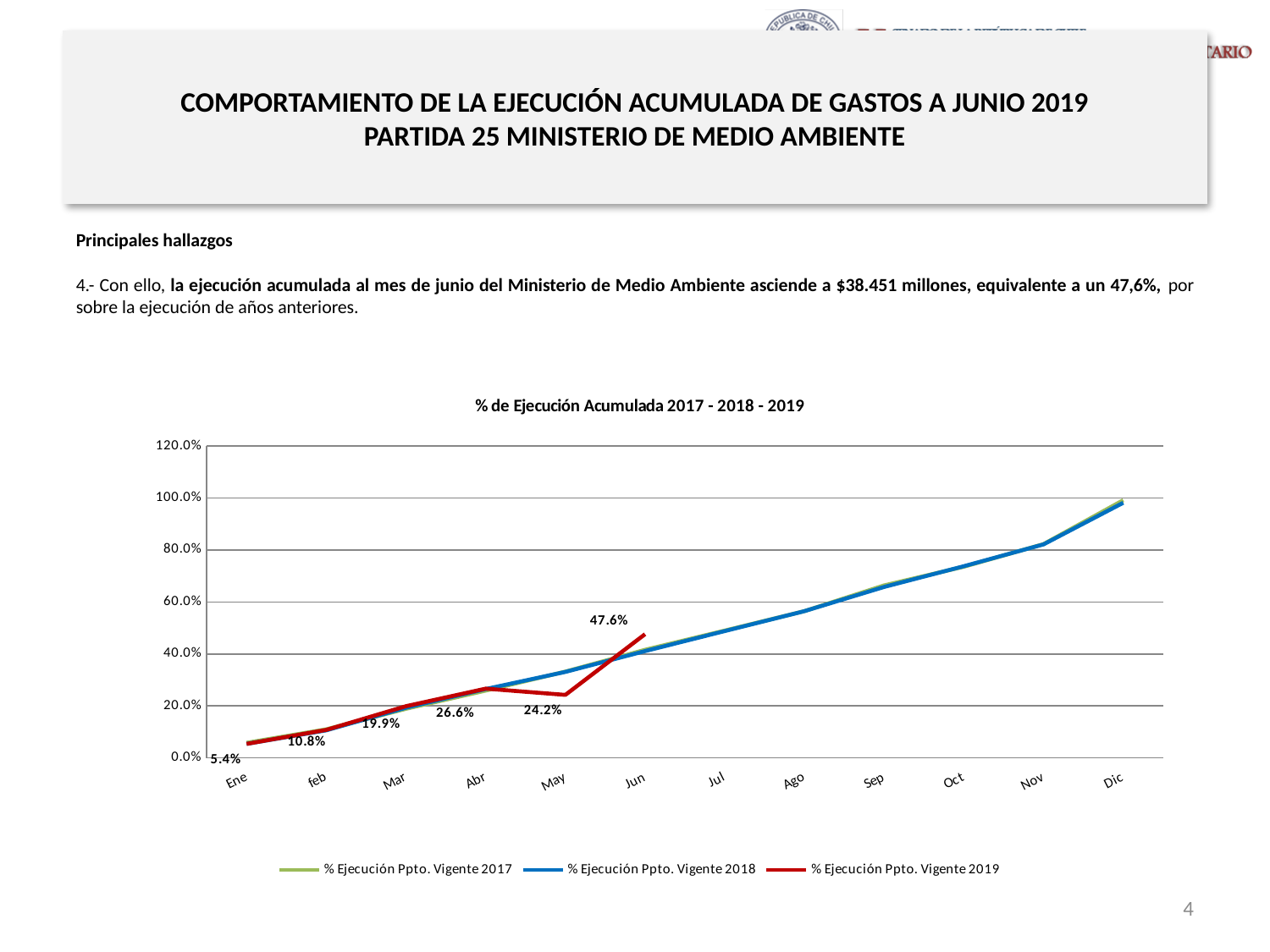
In which month does the % Ejecución Ppto. Vigente 2019 series have its lowest labelled value? Ene In which month does the % Ejecución Ppto. Vigente 2019 series reach its highest labelled value? Jun What is the value of the % Ejecución Ppto. Vigente 2019 series in Jun? 47.6% For the % Ejecución Ppto. Vigente 2019 series, which is larger: the Abr value or the May value? Abr Does the % Ejecución Ppto. Vigente 2018 series rise or fall from Ene to Dic? Rise Is the value of the % Ejecución Ppto. Vigente 2018 series in Dic greater or less than 80.0%? greater What is the value of the % Ejecución Ppto. Vigente 2019 series in Ene? 5.4% How many series does the chart legend list? 3 How many months are shown on the x axis of the chart? 12 What is the value of the % Ejecución Ppto. Vigente 2019 series in May? 24.2% What kind of chart is shown on the slide? Line chart What is the difference between the Jun and May values of the % Ejecución Ppto. Vigente 2019 series? 23.4%